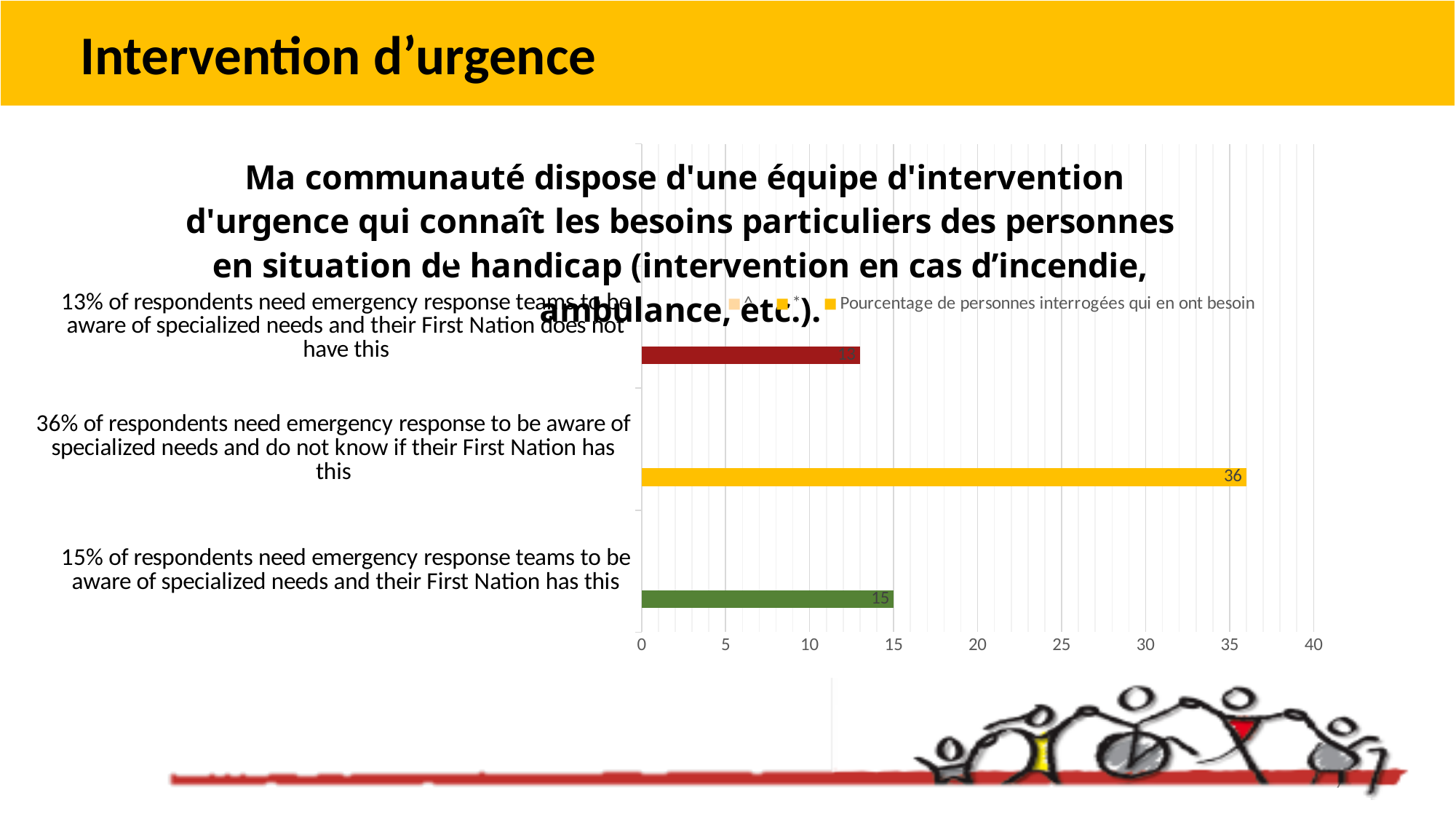
What colour is the bar with the value 36? yellow Which category has the highest value in the chart? 36% of respondents need emergency response to be aware of specialized needs and do not know if their First Nation has this What is the difference between the highest bar value (36) and the lowest bar value (13)? 23 What is the difference between the bar for respondents whose First Nation has this (15) and the bar for respondents whose First Nation does not have this (13)? 2 How many categories (bars) are plotted in the chart? 3 Which category has the lowest value in the chart? 13% of respondents need emergency response teams to be aware of specialized needs and their First Nation does not have this What is the value of the bar for respondents whose First Nation has an emergency response team aware of specialized needs? 15 What is the value of the bar for respondents who do not know if their First Nation has an emergency response team aware of specialized needs? 36 What type of chart is shown on the slide? bar chart What is the value of the bar for respondents whose First Nation does not have an emergency response team aware of specialized needs? 13 Which is larger: the bar for respondents whose First Nation has this, or the bar for respondents whose First Nation does not have this? the bar for respondents whose First Nation has this What is the maximum value shown on the horizontal axis of the chart? 40